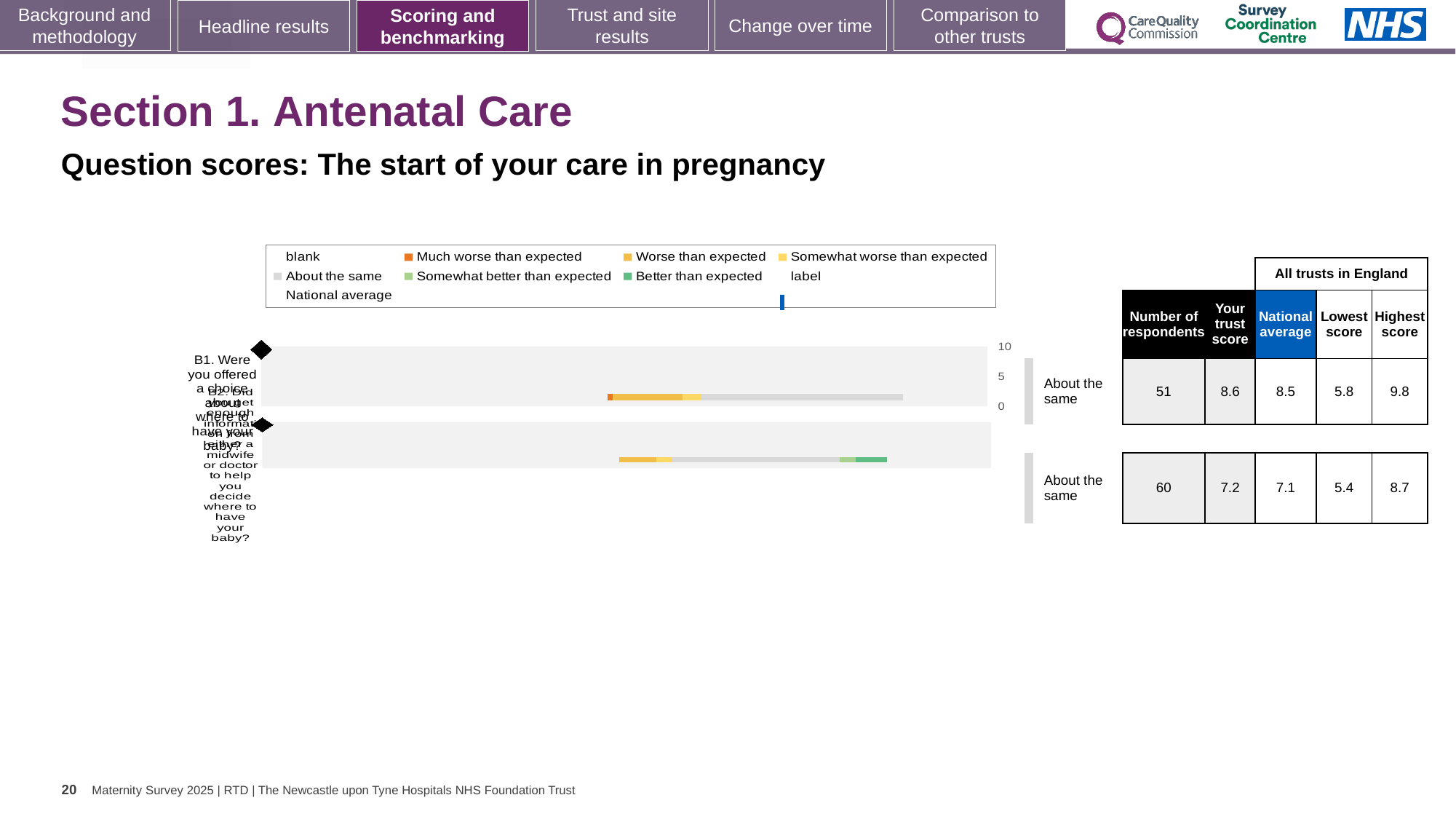
Which question has more respondents, B1 or B2? B2 Which question has the higher trust score, B1 or B2? B1 What colour does the legend use for 'Much worse than expected'? orange How many respondents answered question B1? 51 How many questions (bars) are plotted in the chart? 2 What is the lowest score among all trusts in England for question B1? 5.8 What is the highest score among all trusts in England for question B2? 8.7 What kind of chart is used to show the question scores on this slide? bar chart What is the national average for question B2? 7.1 How is the trust's result for question B2 categorised relative to expectations? About the same What is the trust score for question B1 (Were you offered a choice about where to have your baby?)? 8.6 What is the difference between the trust score and the national average for question B1? 0.1